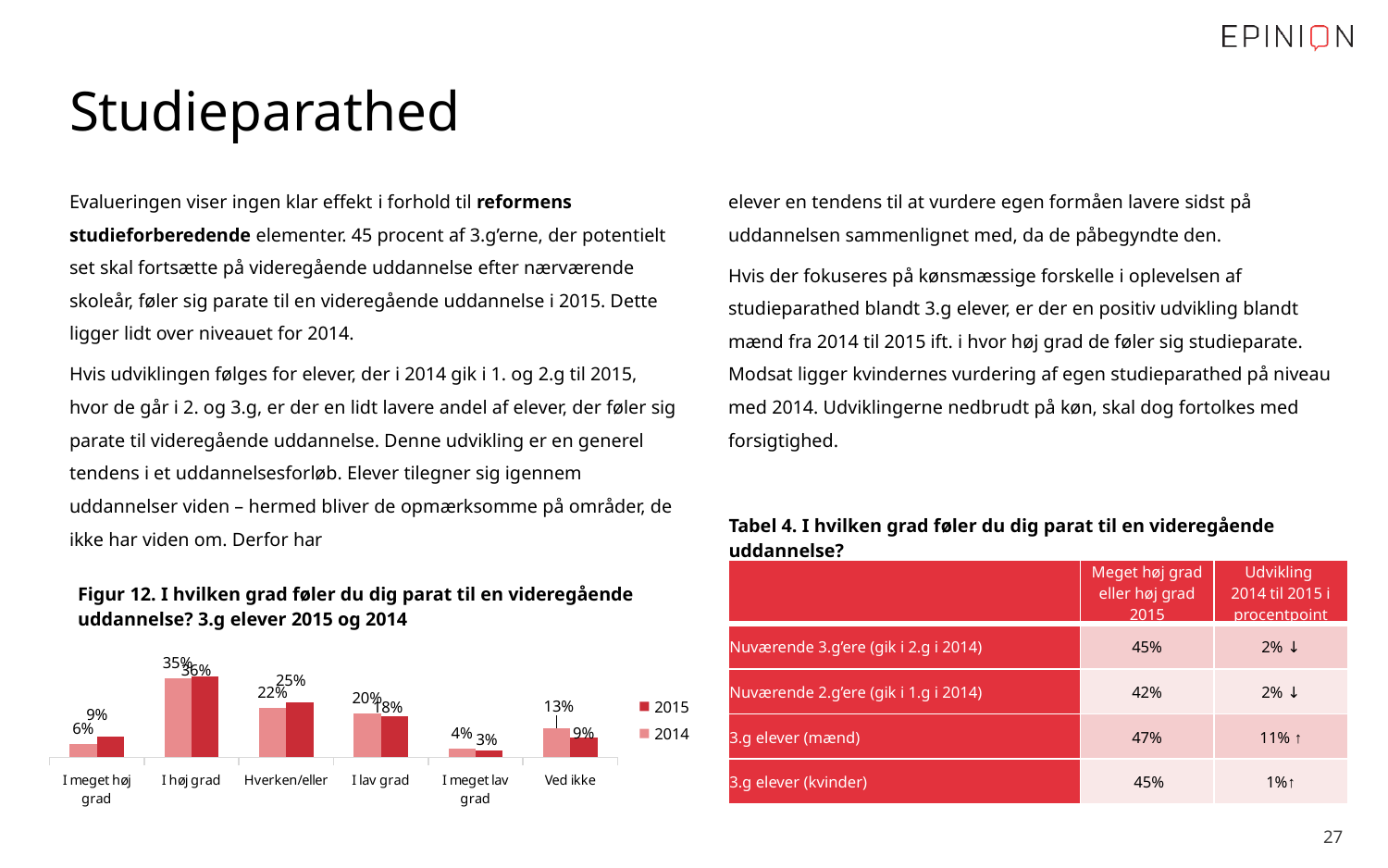
What type of chart is Figur 12? bar chart In Figur 12, what is the difference between the 2014 and 2015 values for 'Ved ikke'? 4% How many categories are shown on the x axis of Figur 12? 6 In Figur 12, what is the 2014 value for 'I lav grad'? 20% In Figur 12, which category has the highest 2015 value? I høj grad In Figur 12, which category has the lowest 2015 value? I meget lav grad In Figur 12, is the 2015 value for 'Hverken/eller' larger or smaller than the 2014 value? larger In Figur 12, what is the 2014 value for 'Ved ikke'? 13% Which series in Figur 12 is shown in the darker red colour? 2015 In Figur 12, what is the difference between the 2015 and 2014 values for 'I meget høj grad'? 3% How many series does the legend of Figur 12 list? 2 In Figur 12, what is the 2015 value for 'I meget høj grad'? 9%